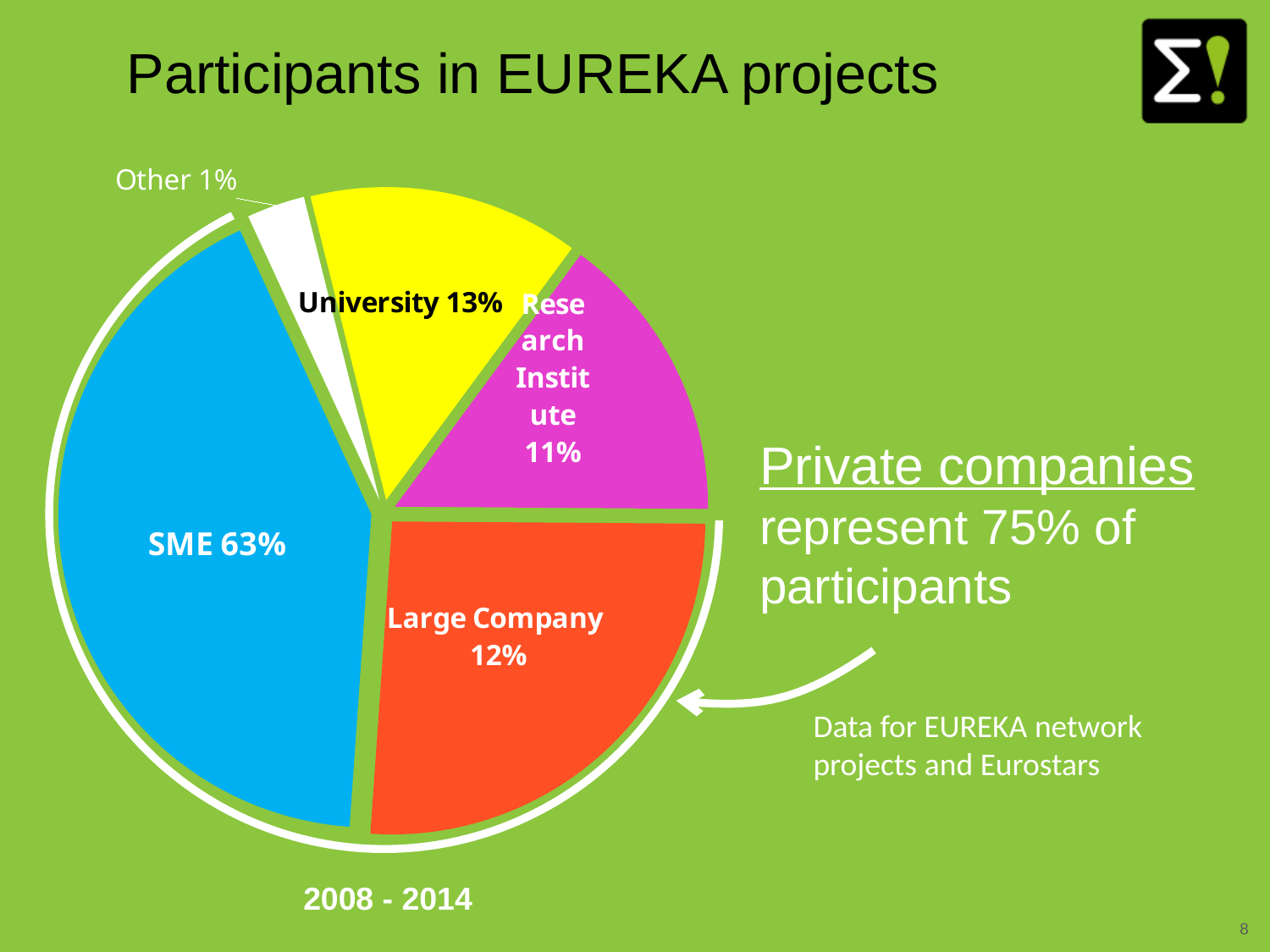
How many categories does the pie chart show? 5 What share of participants are SMEs? 63% Which is larger, the University share or the Research Institute share? University What kind of chart is shown on the slide? Pie chart What share of participants are Research Institutes? 11% What period does the chart cover, according to the label below it? 2008 - 2014 What share of participants are Large Companies? 12% Which category has the smallest share of participants? Other What share of participants are Universities? 13% What share of participants fall under Other? 1% What is the difference in percentage points between the SME share and the Large Company share? 51 Which category has the largest share of participants? SME